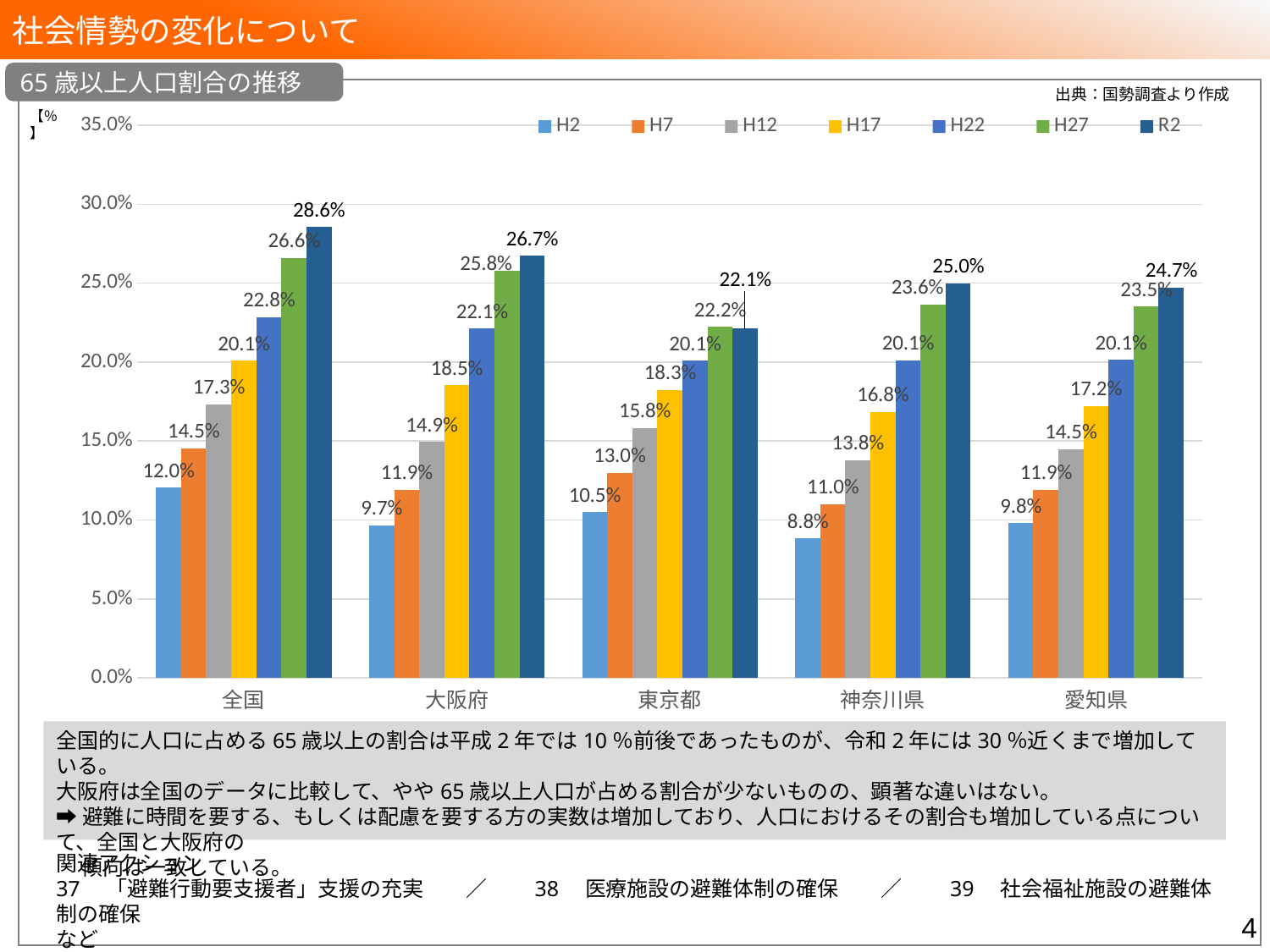
Which is larger, the R2 value for 大阪府 or the R2 value for 東京都? 大阪府 How many categories are shown on the x axis? 5 What kind of chart is shown on the slide? bar chart What is the R2 value for 全国? 28.6% What is the H2 value for 大阪府? 9.7% What is the H27 value for 神奈川県? 23.6% How many series does the legend list? 7 What is the difference between the R2 value and the H2 value for 全国? 16.6% Which category has the lowest H2 value? 神奈川県 For 愛知県, do the values rise or fall from H2 to R2? rise What is the title of the chart? 65歳以上人口割合の推移 Which category has the highest R2 value? 全国